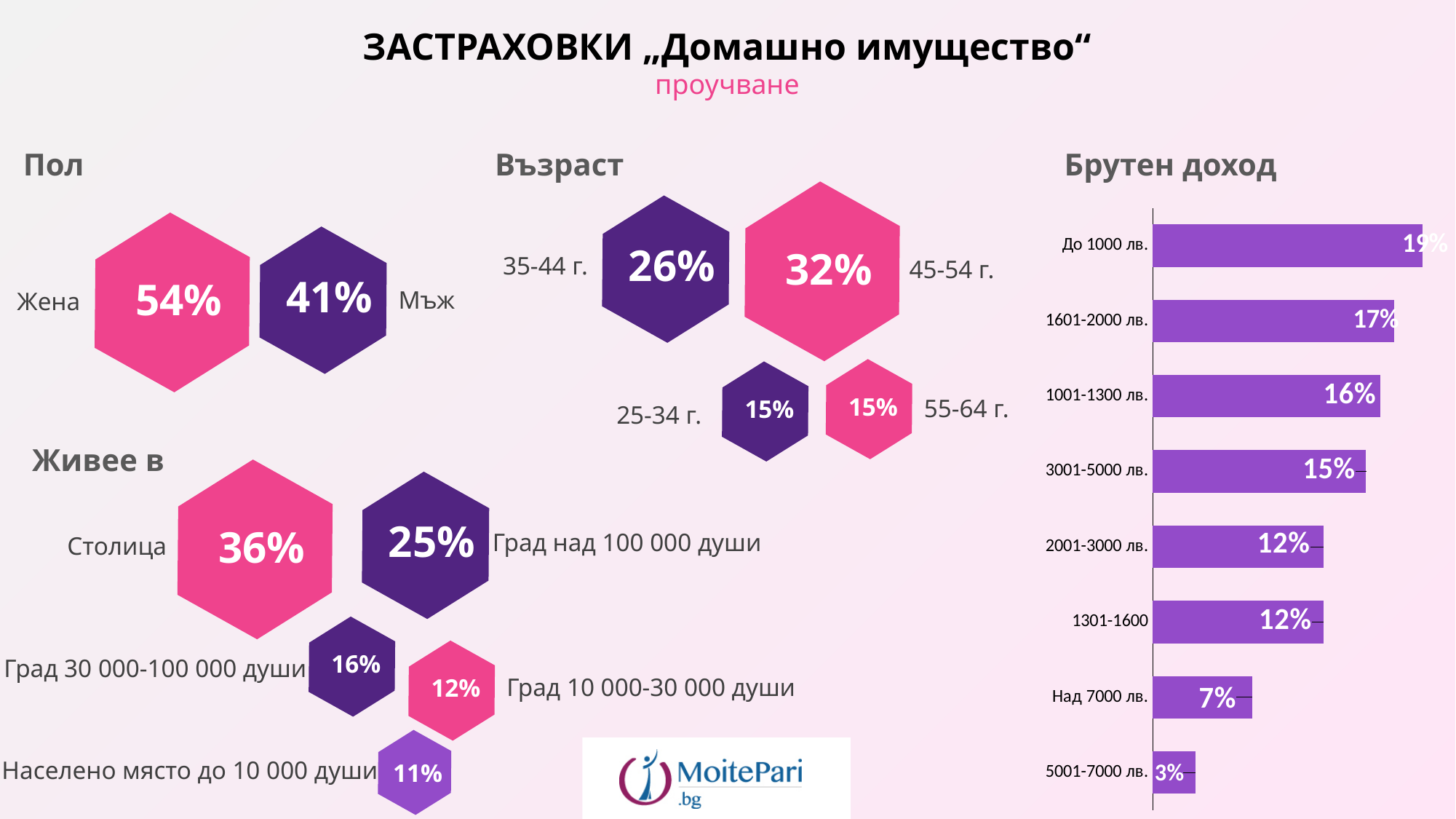
In the "Брутен доход" bar chart, which income category has the lowest value? 5001-7000 лв. In the "Брутен доход" bar chart, do the values rise or fall going from the top bar to the bottom bar? Fall In the "Брутен доход" bar chart, which is larger: the value for "1001-1300 лв." or the value for "2001-3000 лв."? 1001-1300 лв. What type of chart is the "Брутен доход" chart? Bar chart In the "Брутен доход" bar chart, what is the value for "До 1000 лв."? 19% In the "Брутен доход" bar chart, what is the value for "Над 7000 лв."? 7% In the "Брутен доход" bar chart, what is the value for "3001-5000 лв."? 15% How many income categories are shown in the "Брутен доход" bar chart? 8 In the "Пол" section, what percentage is shown for "Жена"? 54% In the "Възраст" section, which age group has the highest percentage? 45-54 г. In the "Брутен доход" bar chart, which income category has the highest value? До 1000 лв. In the "Брутен доход" bar chart, what is the difference between the values for "1601-2000 лв." and "5001-7000 лв."? 14%